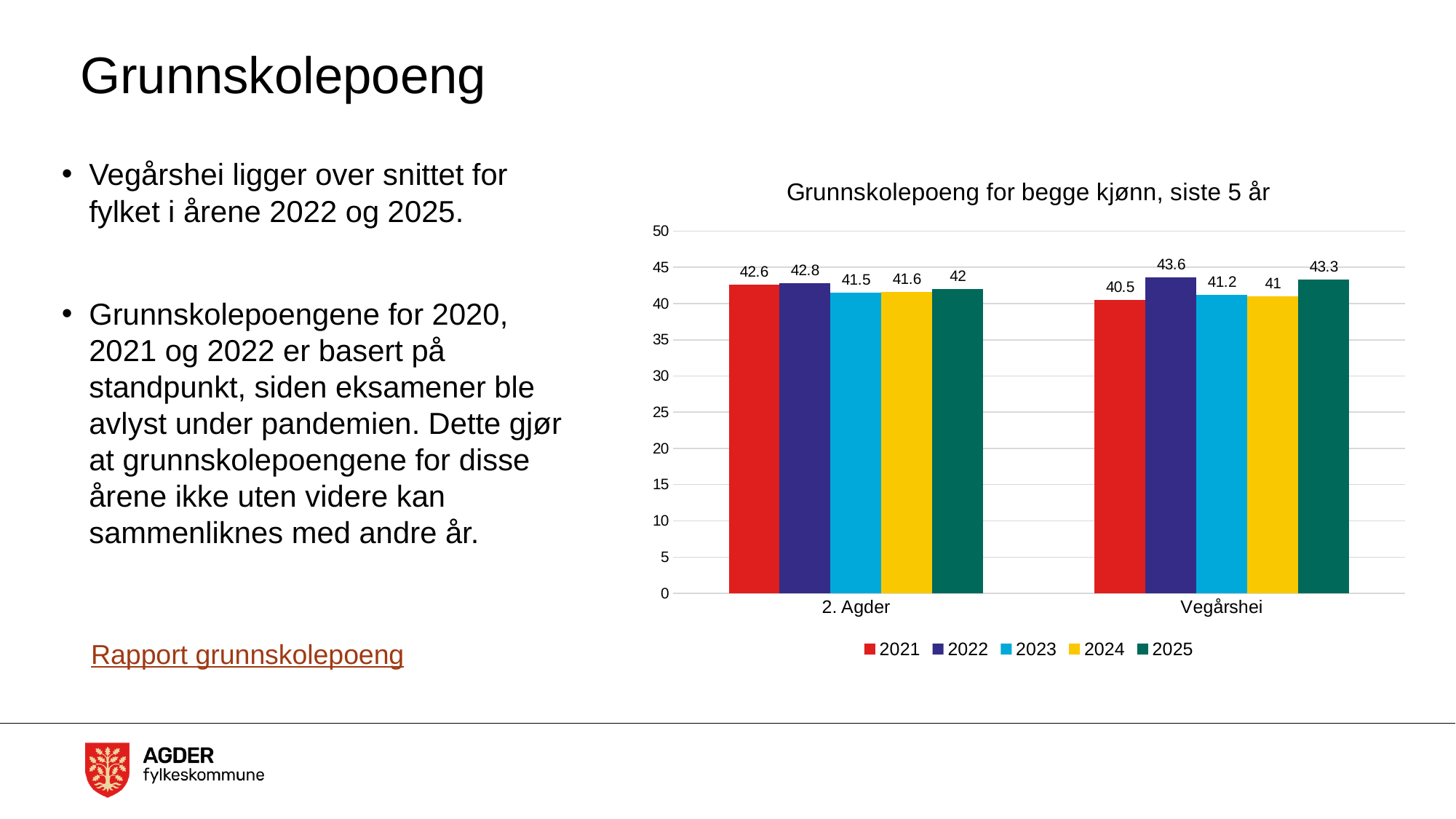
Which is larger in 2021: 2. Agder or Vegårshei? 2. Agder Which year has the highest value for Vegårshei? 2022 What is the value for 2. Agder in 2025? 42 What kind of chart is shown on the slide? Bar chart Which year has the lowest value for Vegårshei? 2021 Which year has the lowest value for 2. Agder? 2023 What is the value for Vegårshei in 2024? 41 How many series does the legend list? 5 What is the title of the chart? Grunnskolepoeng for begge kjønn, siste 5 år What is the value for 2. Agder in 2021? 42.6 What is the difference between Vegårshei and 2. Agder in 2025? 1.3 What is the value for Vegårshei in 2022? 43.6